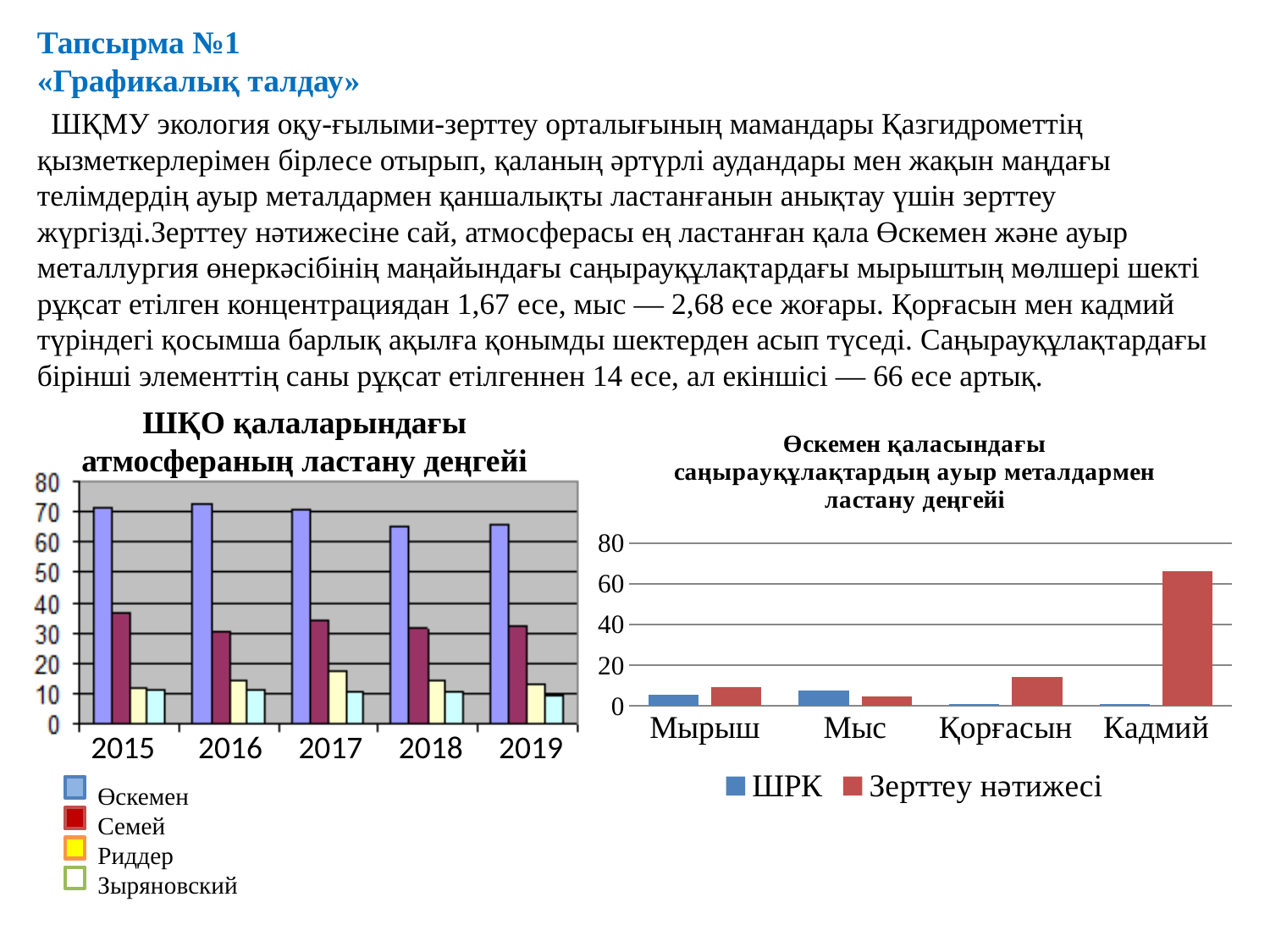
In the left chart "ШҚО қалаларындағы атмосфераның ластану деңгейі", is the value for Зыряновский in 2019 greater or less than 20? less How many series does the legend of the left chart "ШҚО қалаларындағы атмосфераның ластану деңгейі" list? 4 In the right chart "Өскемен қаласындағы саңырауқұлақтардың ауыр металдармен ластану деңгейі", is the Зерттеу нәтижесі value for Кадмий greater or less than 60? greater In the left chart "ШҚО қалаларындағы атмосфераның ластану деңгейі", is the value for Өскемен in 2015 greater or less than 60? greater What kind of chart is the chart titled "ШҚО қалаларындағы атмосфераның ластану деңгейі" on the left? bar chart In the right chart "Өскемен қаласындағы саңырауқұлақтардың ауыр металдармен ластану деңгейі", which metal has the highest Зерттеу нәтижесі value? Кадмий How many series does the legend of the right chart "Өскемен қаласындағы саңырауқұлақтардың ауыр металдармен ластану деңгейі" list? 2 In the right chart "Өскемен қаласындағы саңырауқұлақтардың ауыр металдармен ластану деңгейі", which is larger for Мыс: ШРК or Зерттеу нәтижесі? ШРК In the left chart "ШҚО қалаларындағы атмосфераның ластану деңгейі", which is larger in 2016: Семей or Риддер? Семей In the left chart "ШҚО қалаларындағы атмосфераның ластану деңгейі", which city has the highest bar in 2017? Өскемен How many years are shown on the x axis of the left chart "ШҚО қалаларындағы атмосфераның ластану деңгейі"? 5 What kind of chart is the chart on the right titled "Өскемен қаласындағы саңырауқұлақтардың ауыр металдармен ластану деңгейі"? bar chart